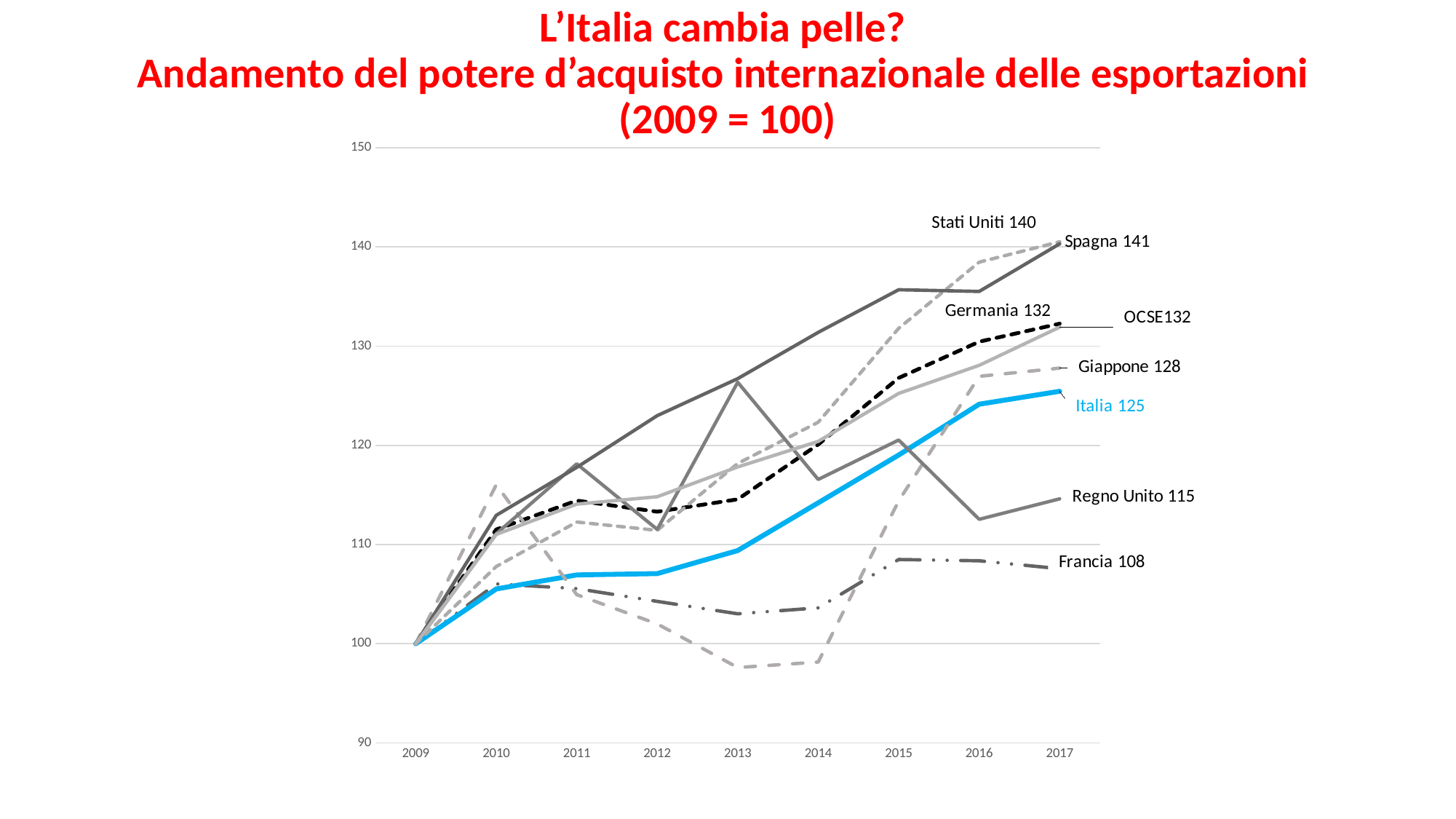
What is the value for Spagna in 2017? 141 Which series has the highest value in 2017? Spagna Which series has the lowest value in 2017? Francia Which is larger in 2017, Giappone or Italia? Giappone What is the value for Francia in 2017? 108 How many series are labelled on the chart? 8 Is the value for Regno Unito in 2016 greater or less than 110? greater Is the value for Giappone in 2013 greater or less than 100? less What is the difference between the 2017 values of Spagna and Italia? 16 What is the value for Italia in 2017? 125 How many years are shown on the x axis? 9 What kind of chart is shown on the slide? line chart